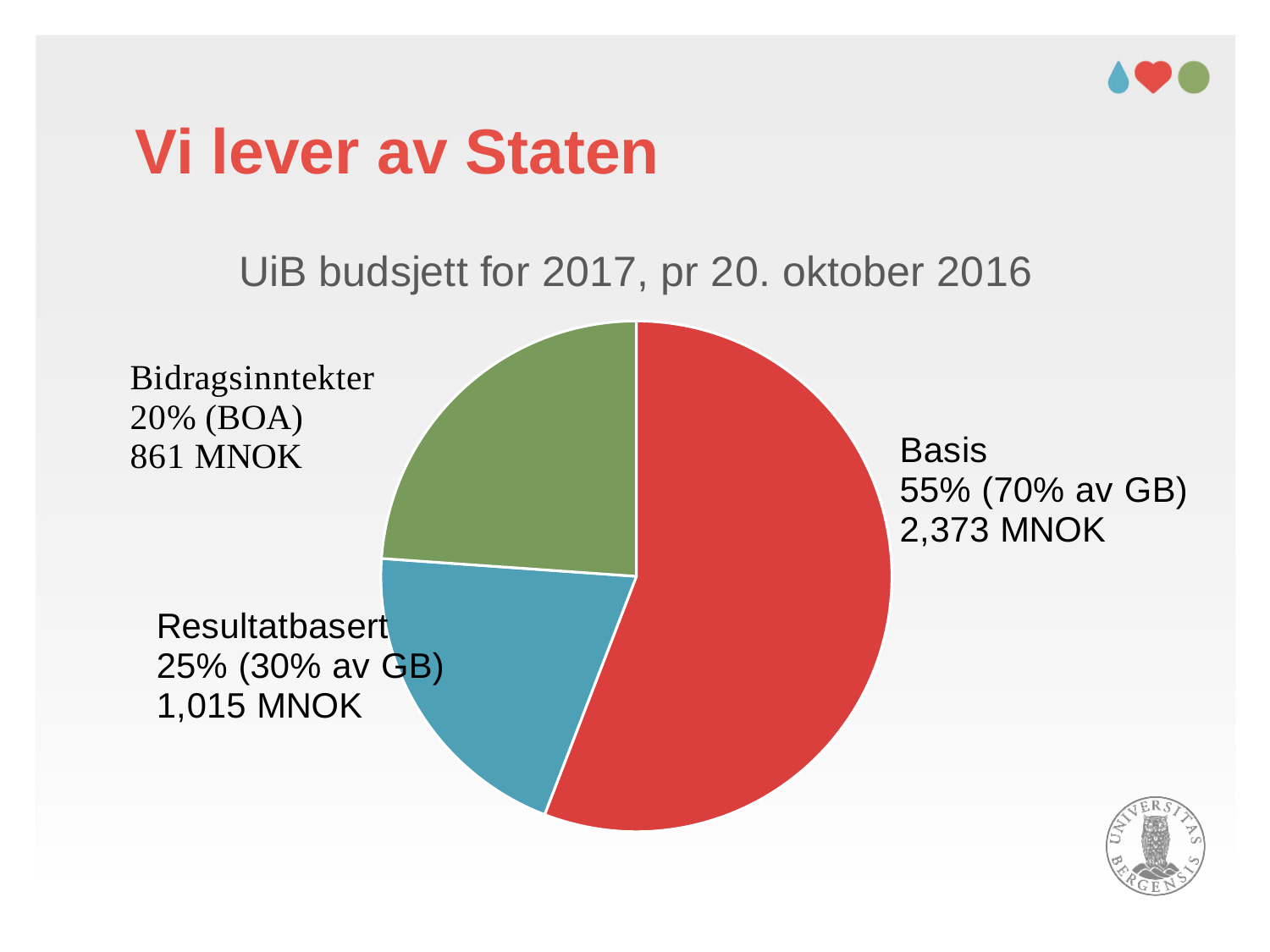
What share of the pie does Basis represent? 55% Which is larger, Resultatbasert or Bidragsinntekter? Resultatbasert Which category has the largest slice of the pie? Basis What is the value in MNOK for Basis? 2,373 MNOK What is the value in MNOK for Bidragsinntekter? 861 MNOK What share of the pie does Bidragsinntekter represent? 20% What is the difference in MNOK between Basis and Resultatbasert? 1,358 MNOK What colour is the Basis slice of the pie? red How many slices does the pie chart have? 3 Which category has the smallest slice of the pie? Bidragsinntekter What type of chart is shown on the slide? pie chart What is the value in MNOK for Resultatbasert? 1,015 MNOK